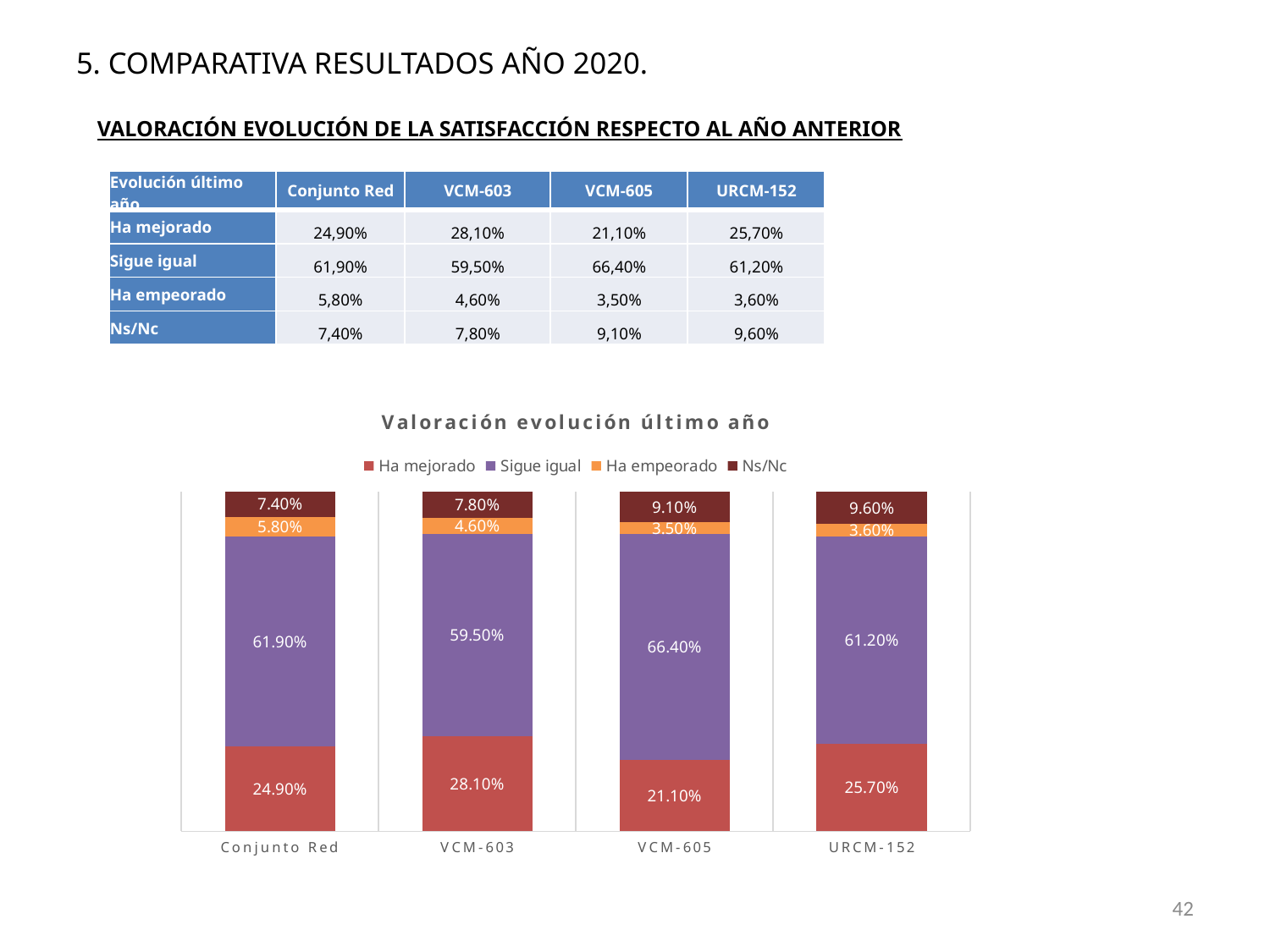
Which category has the lowest 'Ha empeorado' value in the chart? VCM-605 Which is larger in the chart: the 'Ns/Nc' value for VCM-605 or for Conjunto Red? VCM-605 How many series does the legend of the chart list? 4 What is the difference between the 'Sigue igual' values for VCM-605 and VCM-603 in the chart? 6.90% What is the value of 'Ha empeorado' for Conjunto Red in the chart? 5.80% How many categories are shown on the x axis of the chart? 4 What type of chart is shown on the slide? stacked bar chart What is the value of 'Ns/Nc' for URCM-152 in the chart? 9.60% Which category has the highest 'Ha mejorado' value in the chart? VCM-603 What is the value of 'Ha mejorado' for VCM-603 in the chart? 28.10% What is the value of 'Sigue igual' for VCM-605 in the chart? 66.40% What is the title of the chart? Valoración evolución último año